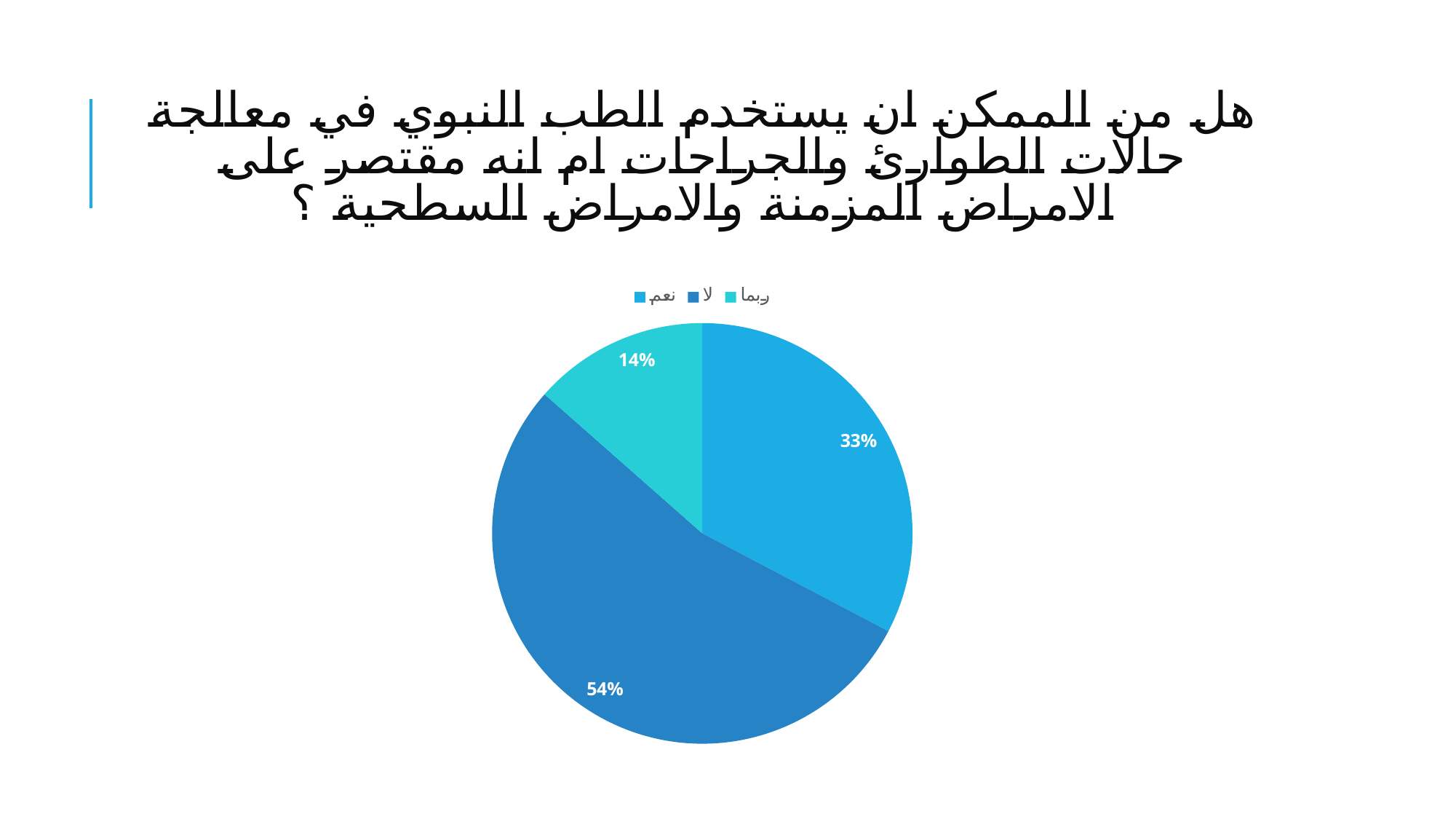
What percentage of the pie chart is labelled for the slice "ربما"? 14% Which category has the largest slice of the pie chart? لا What kind of chart is shown on the slide? Pie chart Which slice is larger, "نعم" or "ربما"? نعم What is the difference in percentage points between the "نعم" slice and the "ربما" slice? 19 Which legend entry is shown in the teal (lightest) colour? ربما What percentage of the pie chart is labelled for the slice "لا"? 54% How many slices does the pie chart have? 3 Which category has the smallest slice of the pie chart? ربما What is the difference in percentage points between the "لا" slice and the "نعم" slice? 21 What percentage of the pie chart is labelled for the slice "نعم"? 33% How many entries does the legend list? 3